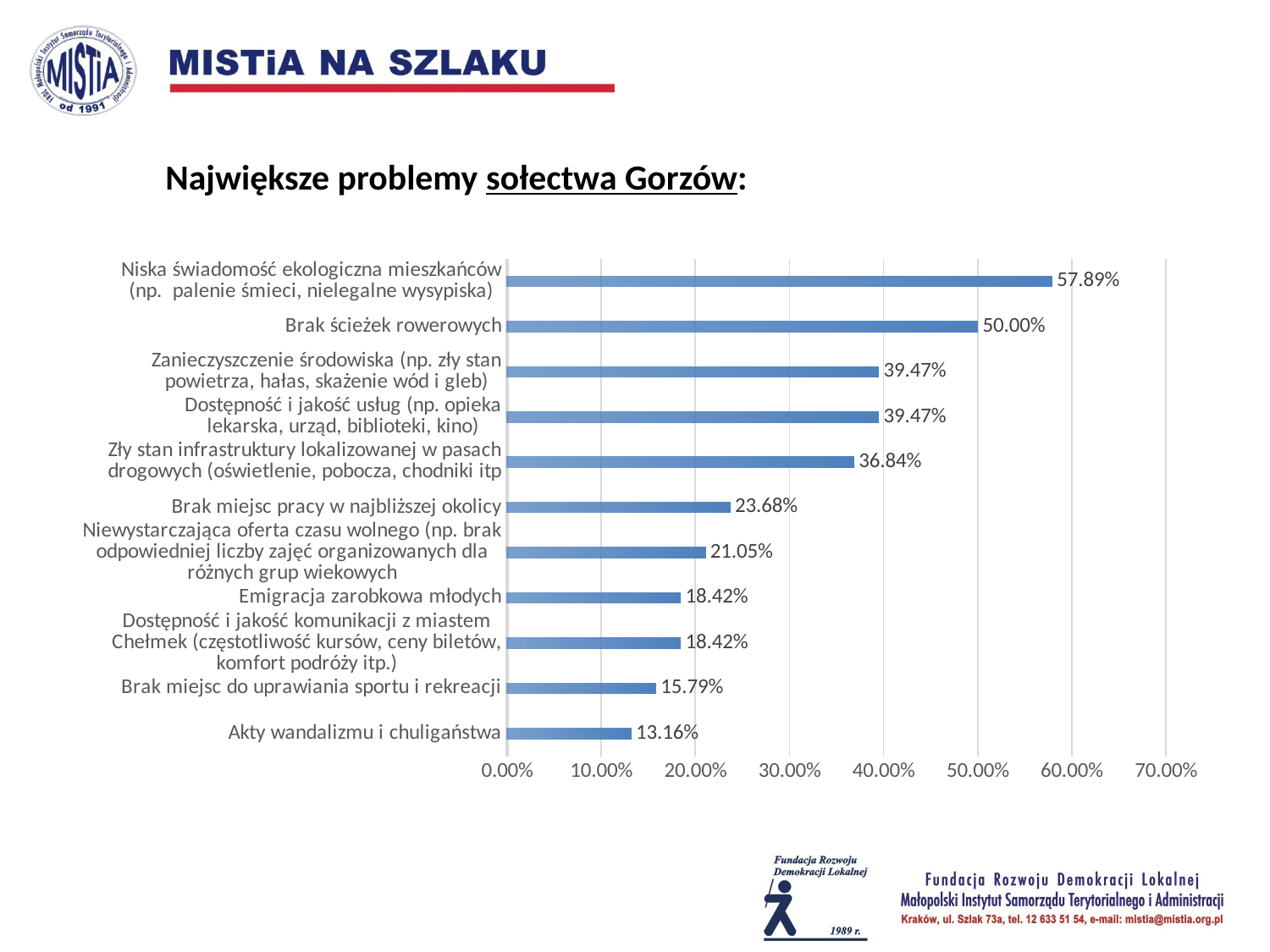
What is the value for "Brak miejsc pracy w najbliższej okolicy"? 23.68% Which category has the lowest value? Akty wandalizmu i chuligaństwa What is the title of the slide above the chart? Największe problemy sołectwa Gorzów: What is the value for "Emigracja zarobkowa młodych"? 18.42% How many categories are shown in the chart? 11 Which category has the highest value? Niska świadomość ekologiczna mieszkańców (np. palenie śmieci, nielegalne wysypiska) What is the difference between the values for "Niska świadomość ekologiczna mieszkańców" and "Brak ścieżek rowerowych"? 7.89% Which is larger: the value for "Brak miejsc pracy w najbliższej okolicy" or the value for "Brak miejsc do uprawiania sportu i rekreacji"? Brak miejsc pracy w najbliższej okolicy What is the value for "Brak ścieżek rowerowych"? 50.00% What kind of chart is shown on the slide? bar chart What is the value for "Akty wandalizmu i chuligaństwa"? 13.16% Is the value for "Zły stan infrastruktury lokalizowanej w pasach drogowych" greater or less than 30.00%? greater